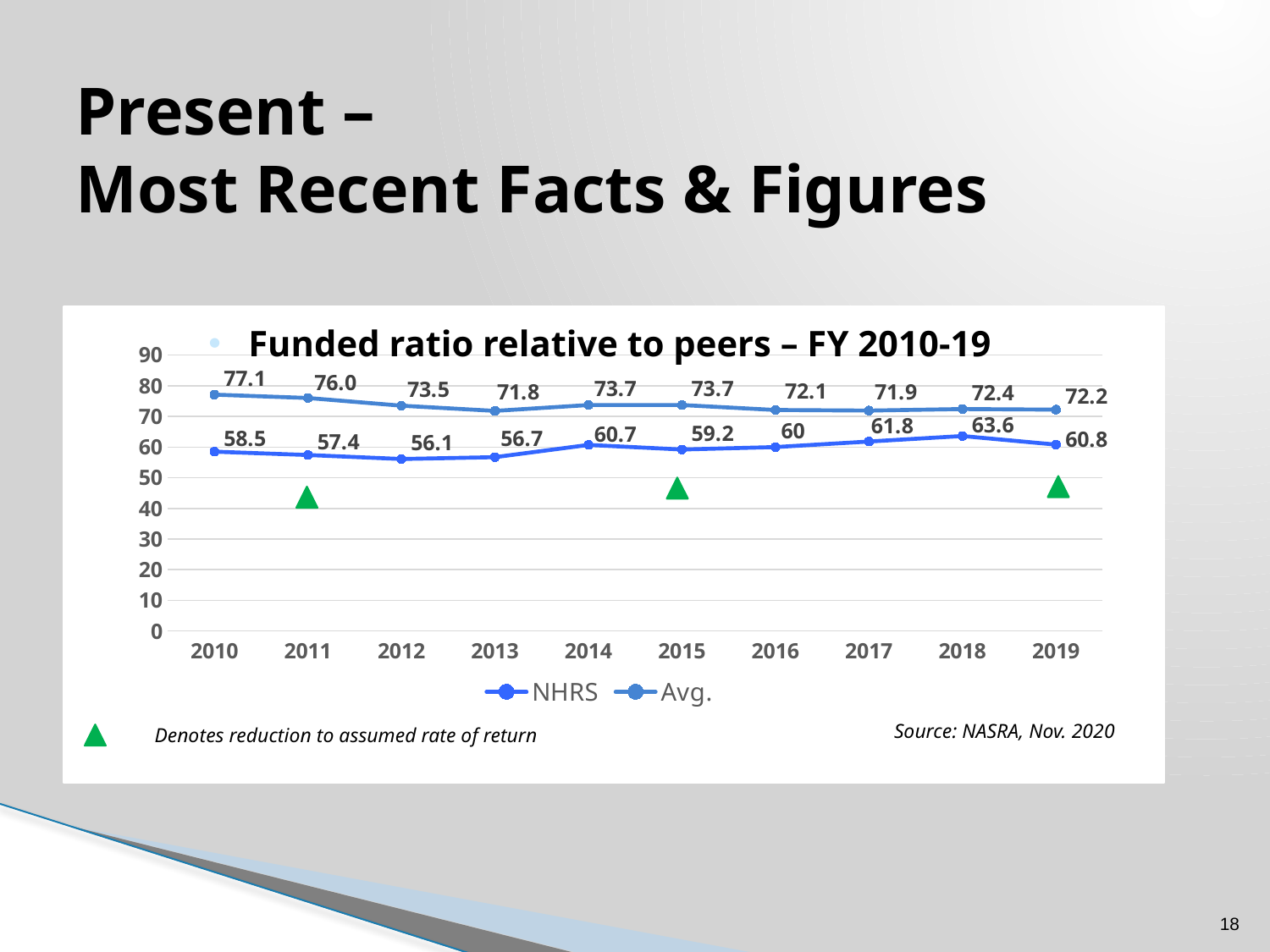
Which series has the higher value in 2015, NHRS or Avg.? Avg. What is the Avg. funded ratio for 2019? 72.2 In which year is the NHRS funded ratio lowest? 2012 What is the NHRS funded ratio for 2010? 58.5 In which year is the Avg. funded ratio highest? 2010 How many series does the legend list? 2 What is the difference between the Avg. and NHRS values in 2010? 18.6 What is the NHRS value for 2016? 60 How many years are shown on the x axis? 10 What is the difference between the NHRS values for 2018 and 2012? 7.5 In which year is the NHRS funded ratio highest? 2018 What kind of chart is shown on the slide? Line chart